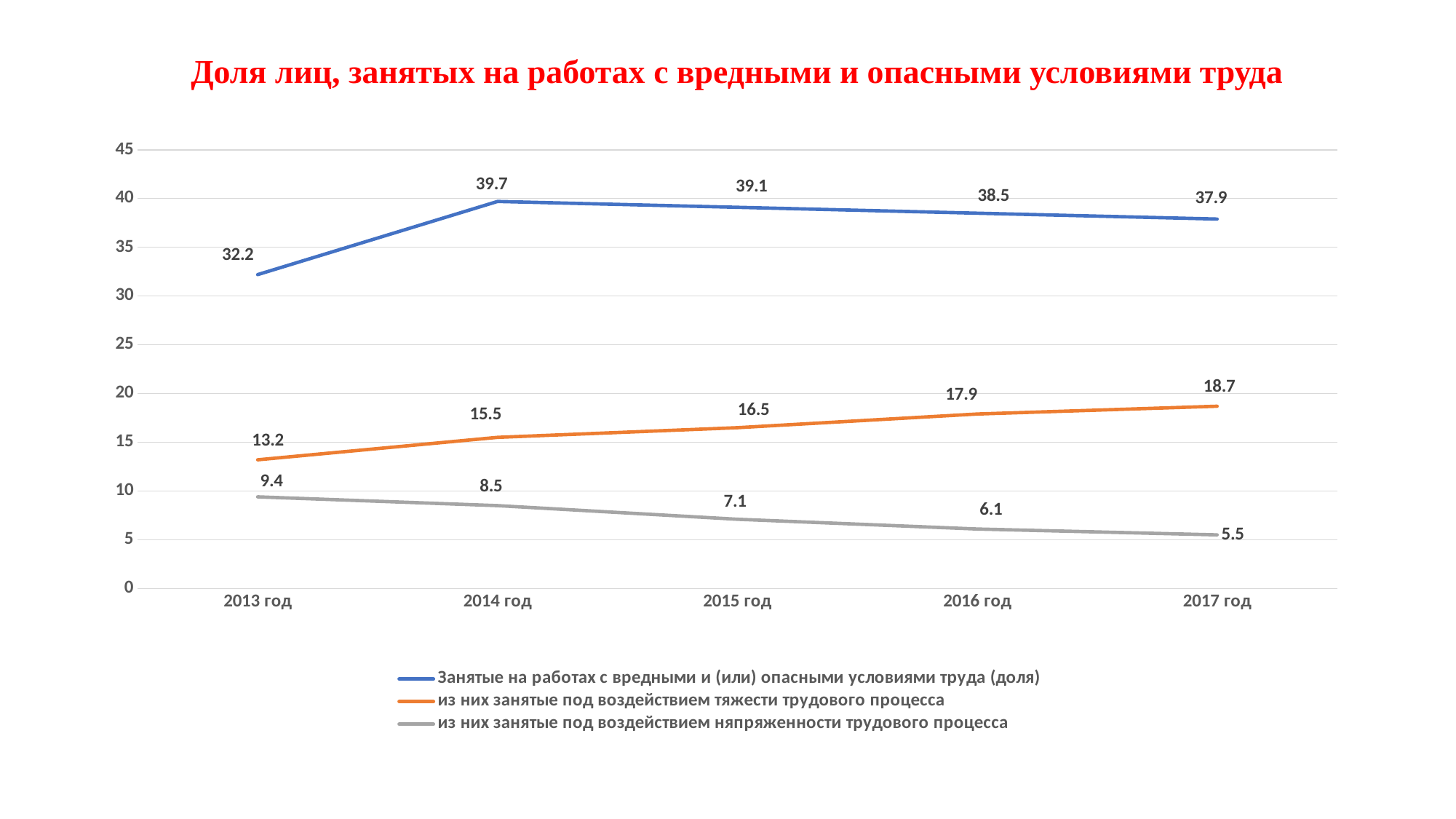
Which is larger in 2016 год: the value for 'из них занятые под воздействием тяжести трудового процесса' or for 'из них занятые под воздействием напряженности трудового процесса'? из них занятые под воздействием тяжести трудового процесса How many years are shown on the x axis? 5 Does the series 'из них занятые под воздействием тяжести трудового процесса' rise or fall from 2013 год to 2017 год? Rise What is the difference between the 2014 год and 2013 год values of the series 'Занятые на работах с вредными и (или) опасными условиями труда (доля)'? 7.5 What is the value of the series 'Занятые на работах с вредными и (или) опасными условиями труда (доля)' for 2014 год? 39.7 In which year is the series 'из них занятые под воздействием напряженности трудового процесса' at its lowest? 2017 год In which year does the series 'Занятые на работах с вредными и (или) опасными условиями труда (доля)' reach its highest value? 2014 год What kind of chart is shown on the slide? Line chart How many series does the legend list? 3 What is the title of the chart? Доля лиц, занятых на работах с вредными и опасными условиями труда What is the value of the series 'из них занятые под воздействием тяжести трудового процесса' for 2017 год? 18.7 What is the value of the series 'из них занятые под воздействием напряженности трудового процесса' for 2015 год? 7.1